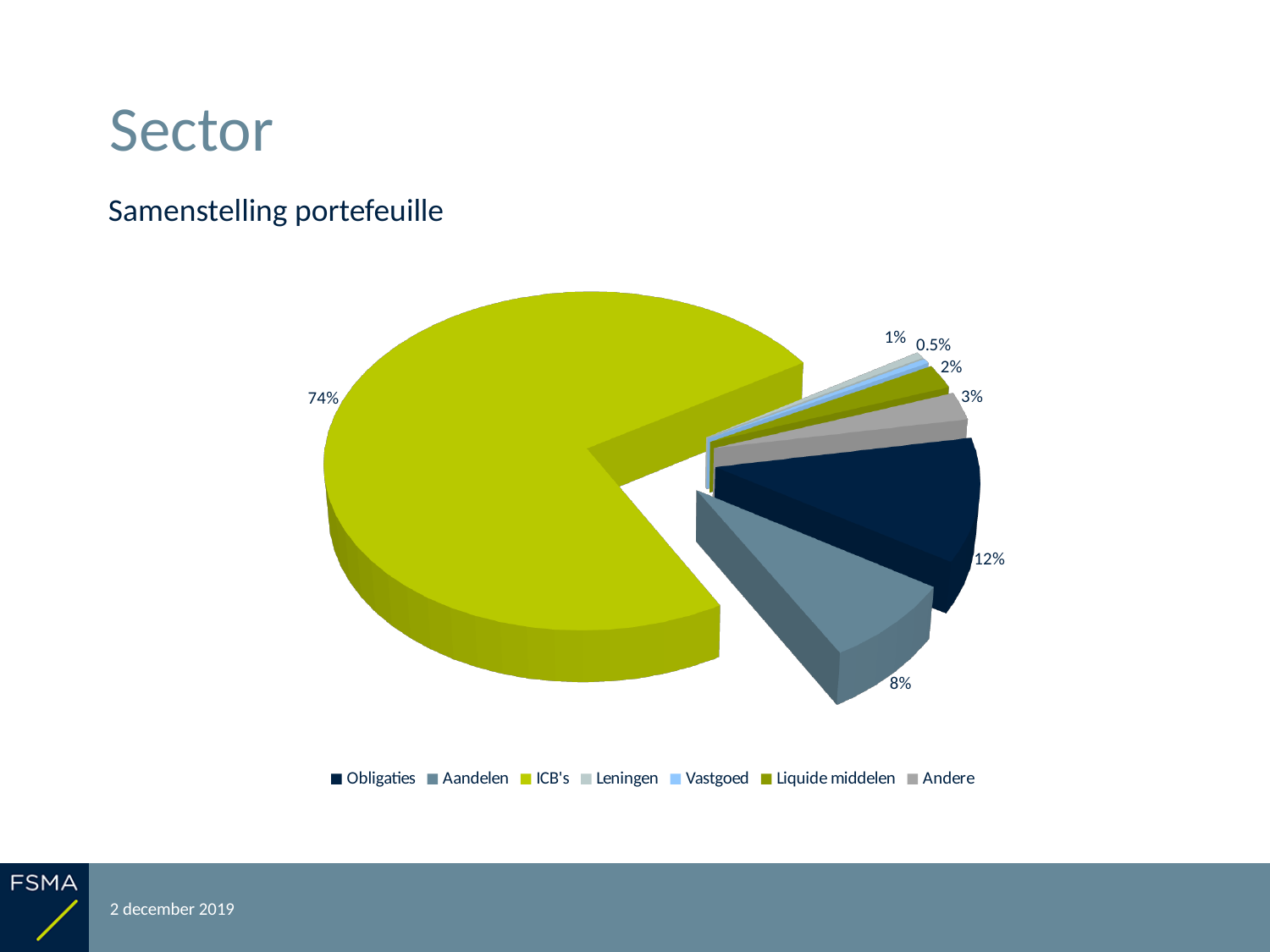
What share of the portfolio is Vastgoed? 0.5% Which category has the smallest slice of the pie? Vastgoed What share of the portfolio is ICB's? 74% What is the subtitle of the chart on the slide? Samenstelling portefeuille How many categories does the legend list? 7 What kind of chart is shown on the slide? pie chart What share of the portfolio is Aandelen? 8% Which is larger, the share for Obligaties or the share for Aandelen? Obligaties Which category has the largest slice of the pie? ICB's What is the difference between the share for ICB's and the share for Obligaties? 62% What share of the portfolio is Obligaties? 12% What share of the portfolio is Andere? 3%